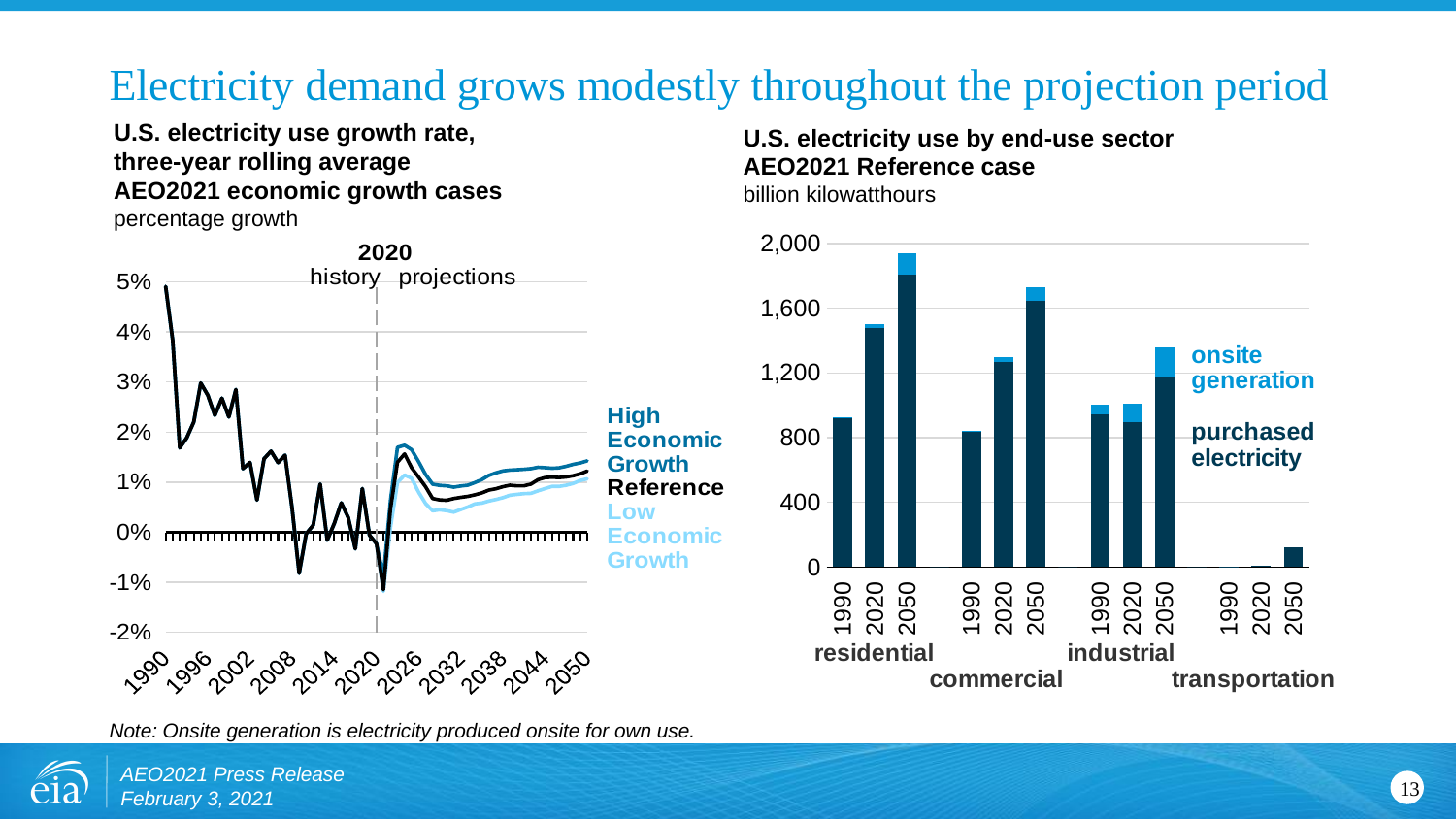
How many bars are plotted in the chart titled 'U.S. electricity use by end-use sector'? 12 In the chart titled 'U.S. electricity use by end-use sector', which sector and year has the tallest bar? residential 2050 In the chart titled 'U.S. electricity use by end-use sector', is the total for commercial in 1990 greater or less than 1,200? less In the chart titled 'U.S. electricity use by end-use sector', which is larger in 2050: residential or industrial? residential In the chart titled 'U.S. electricity use growth rate, three-year rolling average', is the growth rate in 1990 greater or less than 4%? greater What kind of chart is the chart titled 'U.S. electricity use by end-use sector'? bar chart In the chart titled 'U.S. electricity use growth rate, three-year rolling average', what year does the dashed vertical line separating history from projections mark? 2020 In the chart titled 'U.S. electricity use by end-use sector', is the total for residential in 2050 greater or less than 1,600? greater How many series are shown in the chart titled 'U.S. electricity use growth rate, three-year rolling average'? 3 What kind of chart is the chart titled 'U.S. electricity use growth rate, three-year rolling average'? line chart In the chart titled 'U.S. electricity use by end-use sector', which sector has the smallest bars? transportation How many series does the legend list in the chart titled 'U.S. electricity use by end-use sector'? 2